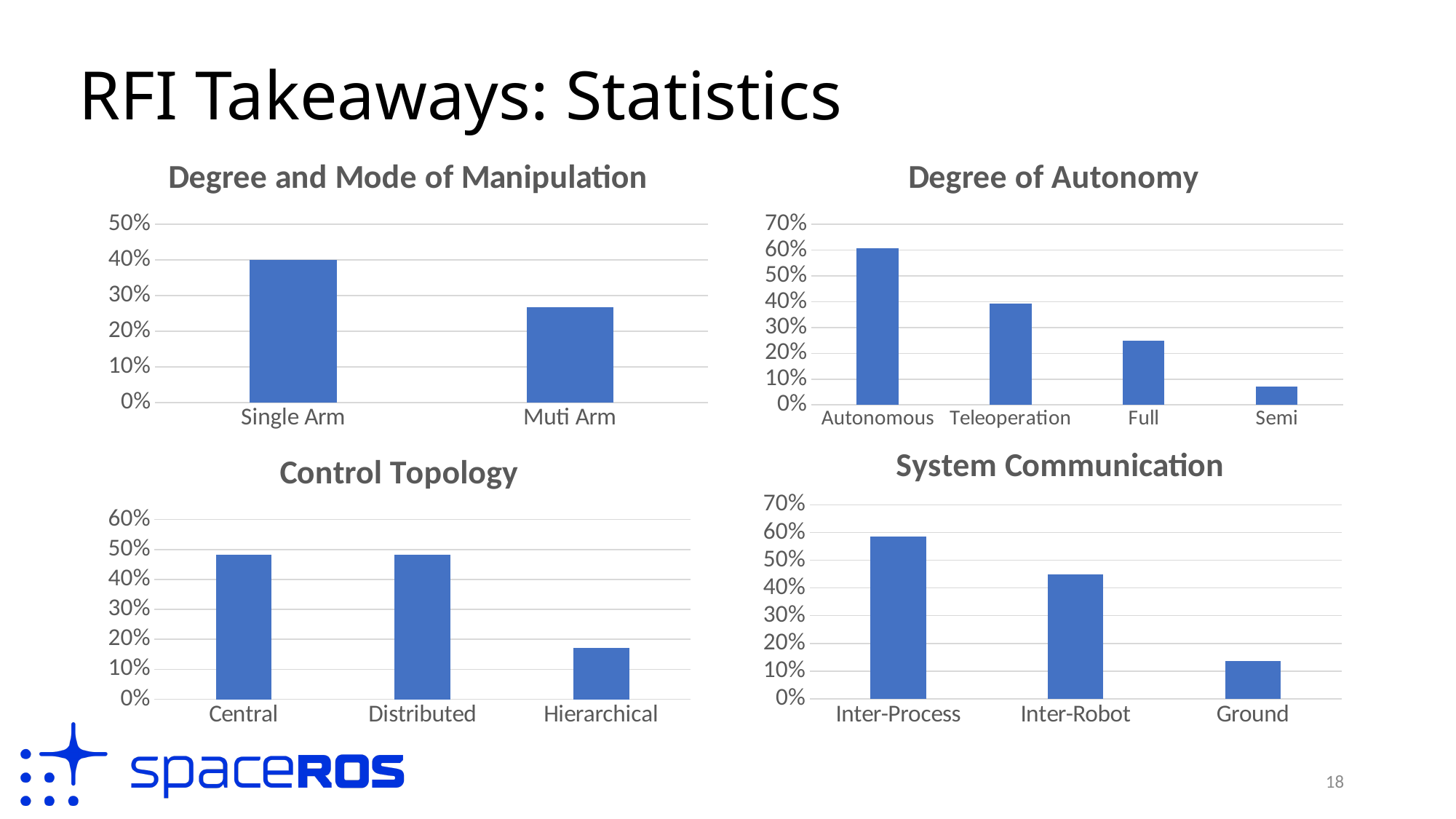
In the Degree of Autonomy chart, which category has the highest value? Autonomous In the Degree of Autonomy chart, which category has the lowest value? Semi In the Degree of Autonomy chart, is the value for Full greater or less than 30%? less In the Degree of Autonomy chart, is the value for Autonomous greater or less than 50%? greater In the Control Topology chart, is the value for Central greater or less than 40%? greater What type of chart is the System Communication chart? bar chart In the Control Topology chart, which category has the lowest value? Hierarchical In the Degree and Mode of Manipulation chart, which category has the higher value? Single Arm In the System Communication chart, which is larger, Inter-Process or Ground? Inter-Process How many categories are shown in the Degree and Mode of Manipulation chart? 2